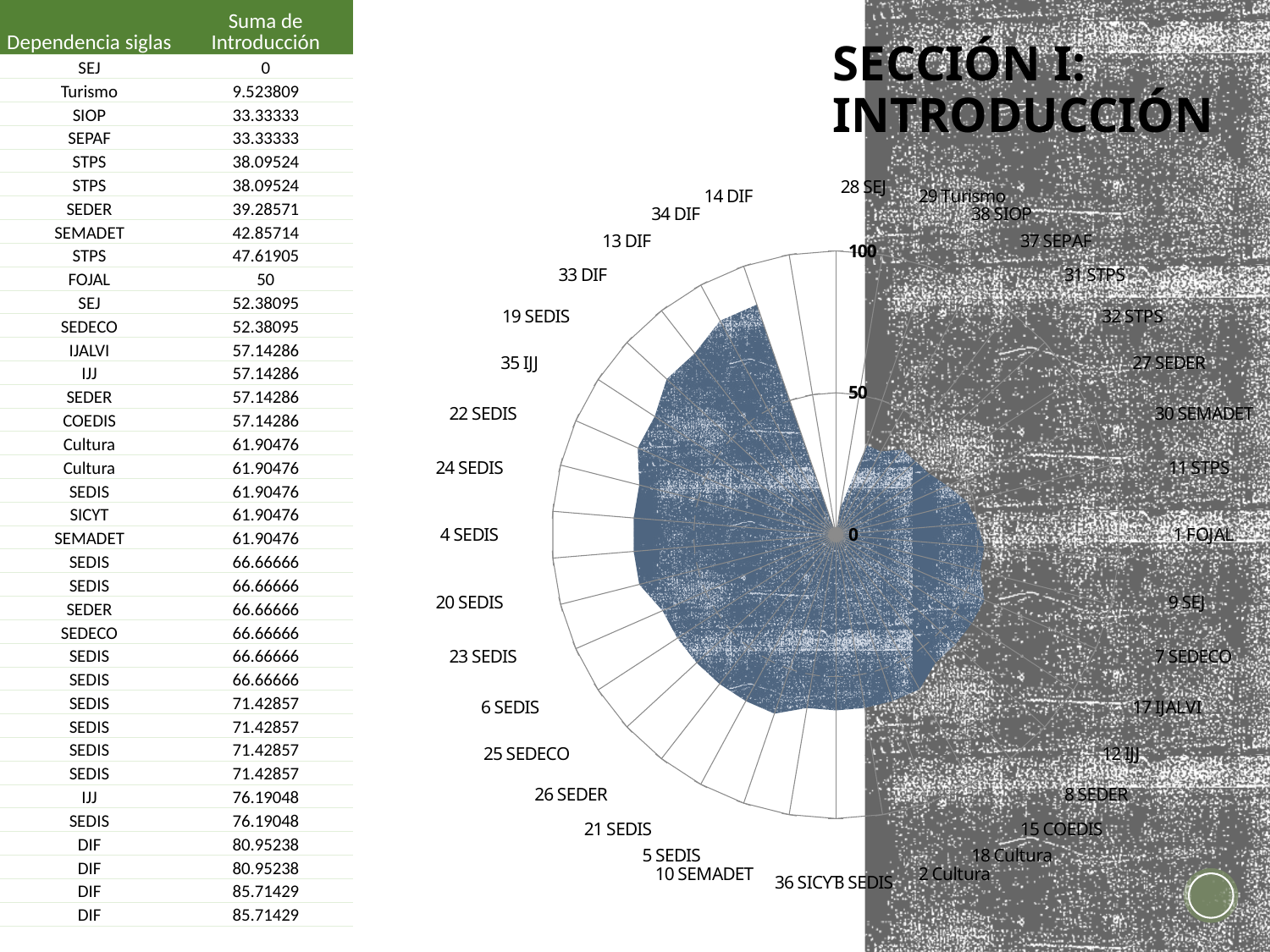
Which is larger, the value for 14 DIF or the value for 28 SEJ? 14 DIF Which is larger, the value for 29 Turismo or the value for 33 DIF? 33 DIF Which category has the lowest value on the radar chart? 28 SEJ What kind of chart is shown on the slide? Radar chart Is the value for 14 DIF greater or less than 50? greater What is the highest tick value shown on the radar chart's axis? 100 Is the value for 29 Turismo greater or less than 50? less What colour is the filled area of the radar chart? Blue Is the value for 4 SEDIS greater or less than 50? greater